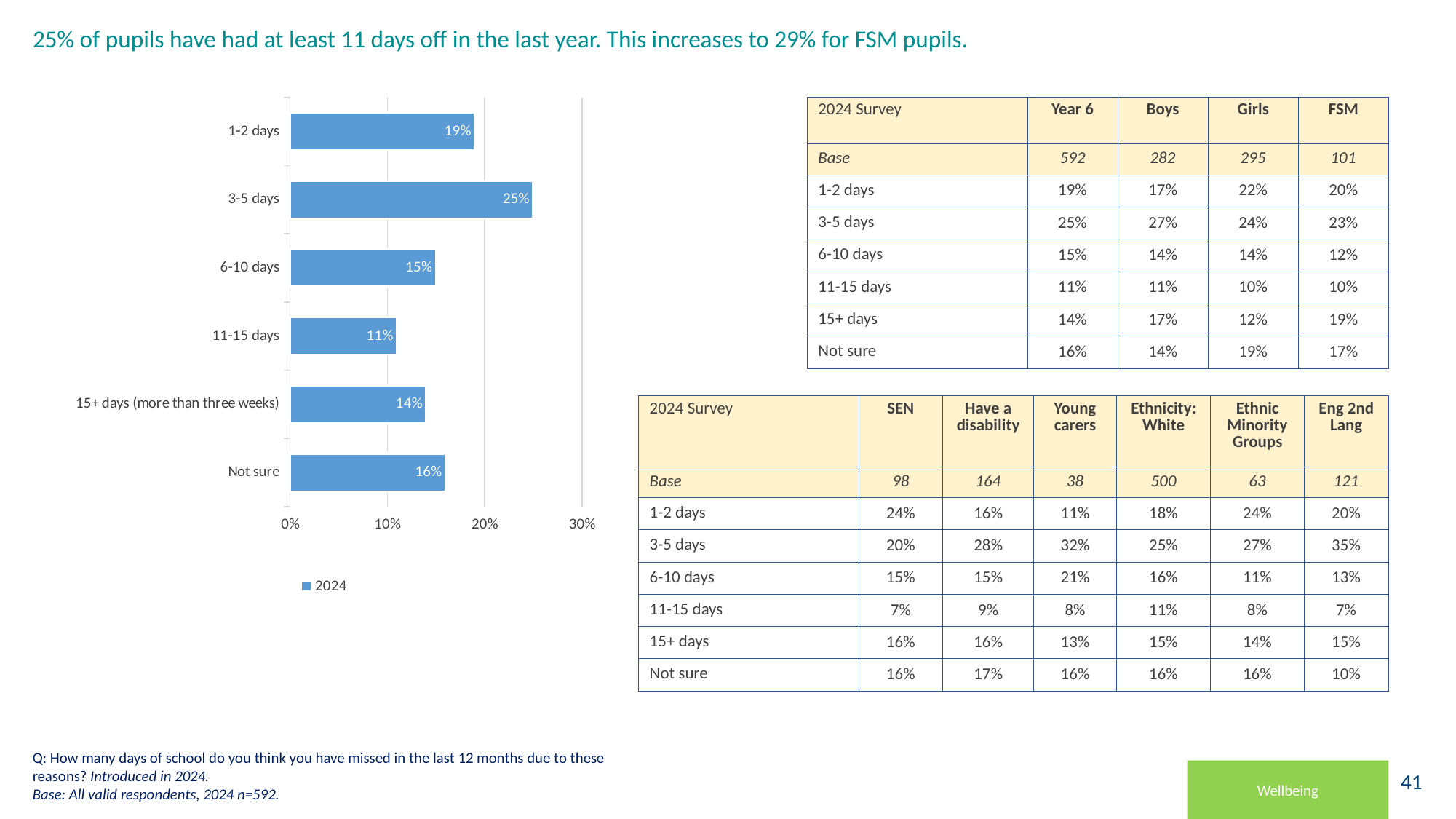
Which is larger in the bar chart, the value for 1-2 days or the value for Not sure? 1-2 days Which category has the lowest value in the bar chart? 11-15 days What is the value for 3-5 days in the bar chart? 25% What is the value for 15+ days (more than three weeks) in the bar chart? 14% What kind of chart is shown on the slide? bar chart What is the difference between the values for 3-5 days and 6-10 days in the bar chart? 10% How many series does the legend of the bar chart list? 1 What is the value for Not sure in the bar chart? 16% Which category has the highest value in the bar chart? 3-5 days Is the value for 6-10 days in the bar chart greater or less than 20%? less What is the value for 11-15 days in the bar chart? 11% How many categories are shown in the bar chart? 6